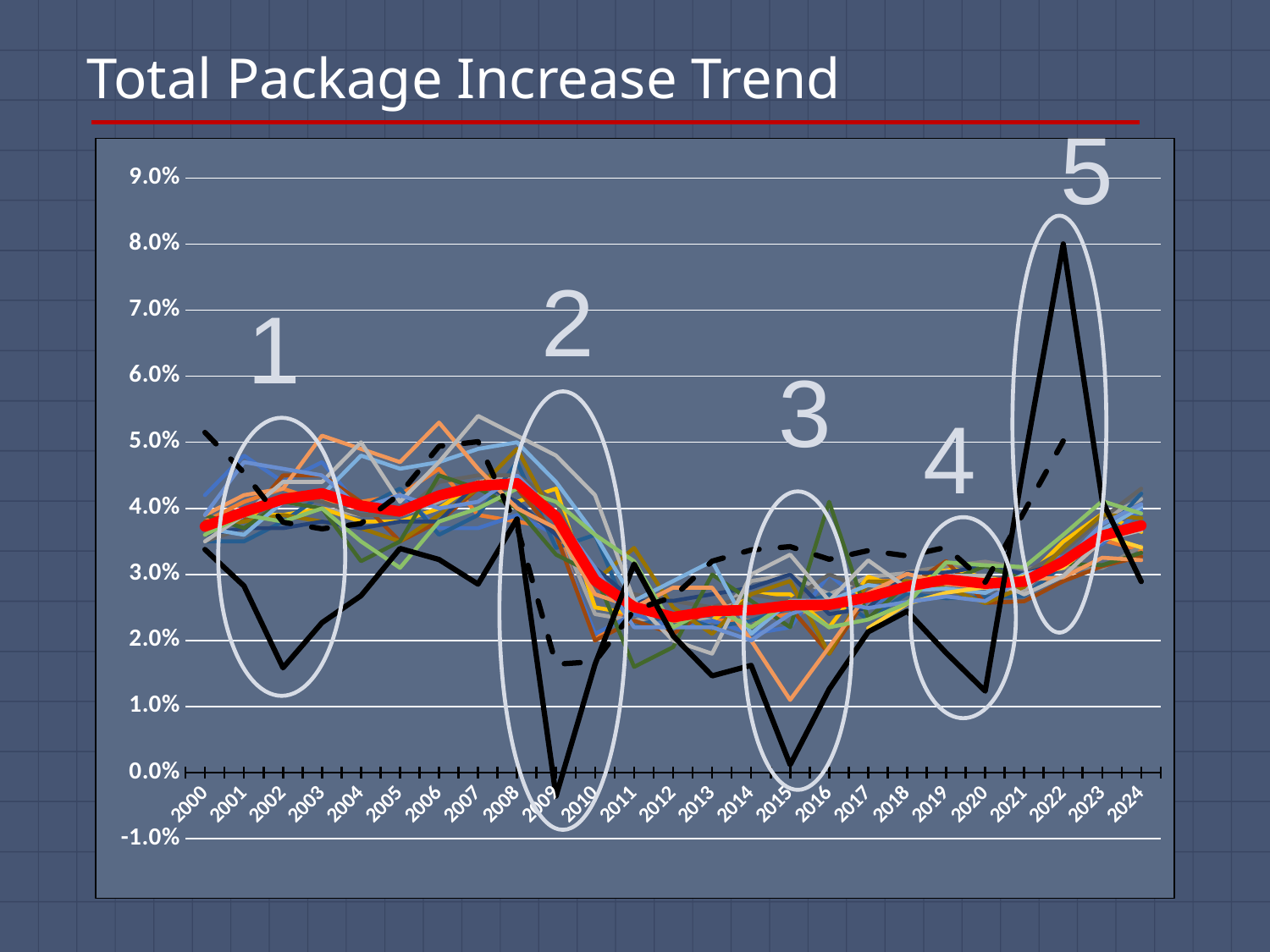
Does the thick red line rise or fall between 2008 and 2010? fall How many years are shown along the x axis of the chart? 25 Is the value of the thick red line in 2008 greater or less than 4.0%? greater In which year does the solid black line reach its highest value? 2022 Is the value of the solid black line in 2009 greater or less than 1.0%? less Does the thick red line rise or fall between 2020 and 2024? rise Is the value of the solid black line in 2022 greater or less than 7.0%? greater What kind of chart is shown on the slide? line chart How many numbered ellipses are drawn on the chart? 5 What is the title of the chart? Total Package Increase Trend Is the thick red line higher in 2008 or in 2015? 2008